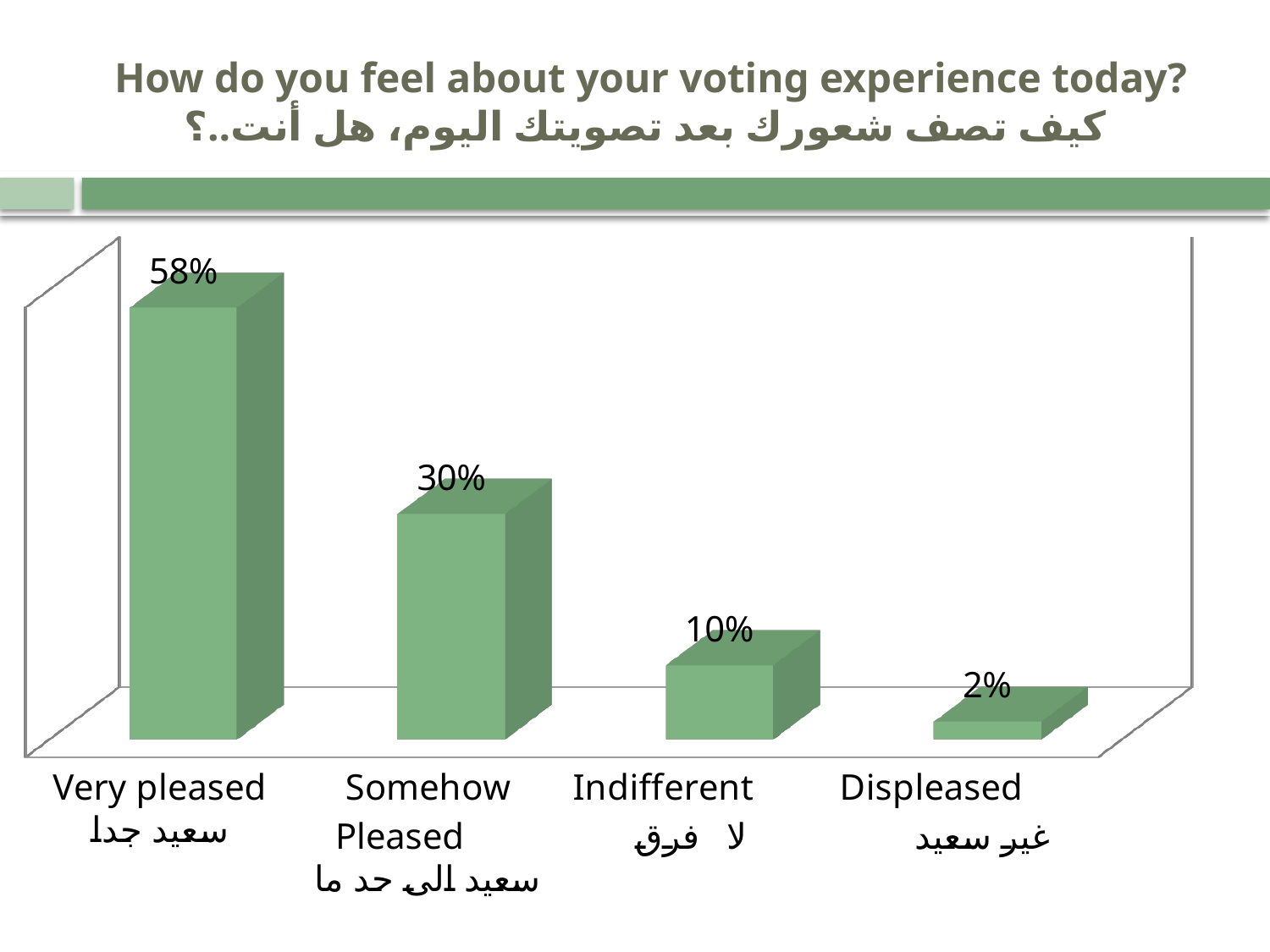
What is the difference between the Indifferent and Displeased values? 8% How many categories are shown in the chart? 4 What is the value shown for Indifferent? 10% What is the value shown for Somehow Pleased? 30% What percentage of respondents said they were Very pleased with their voting experience? 58% Which category has the highest value? Very pleased What kind of chart is shown on the slide? Bar chart Which category has the lowest value? Displeased Which is larger, the value for Somehow Pleased or the value for Indifferent? Somehow Pleased What is the difference between the Very pleased and Somehow Pleased values? 28% What is the value shown for Displeased? 2% Do the values rise or fall moving from left to right across the categories? Fall